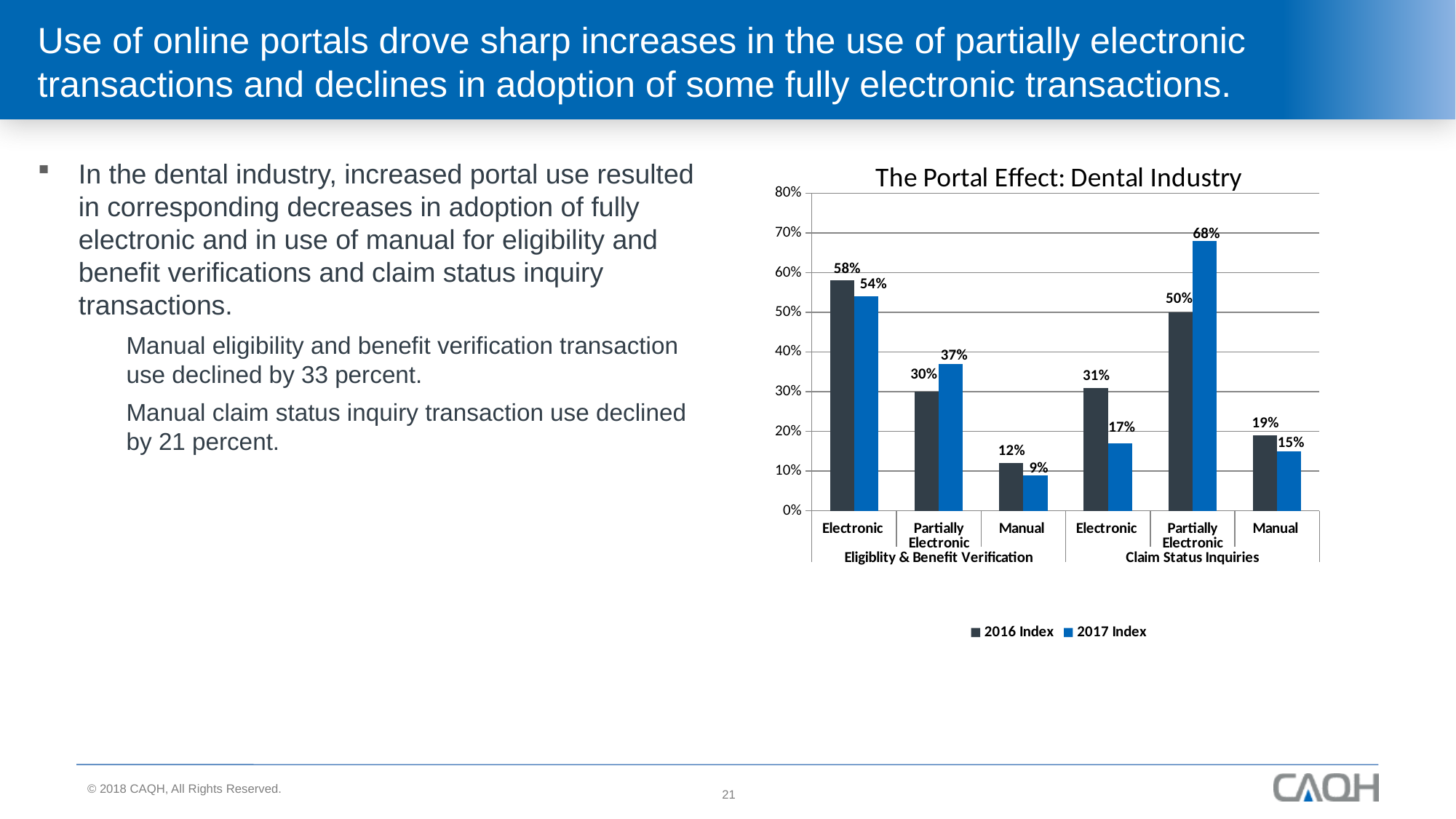
What is the 2017 Index value for Manual under Eligiblity & Benefit Verification? 9% What is the difference between the 2016 Index and 2017 Index values for Partially Electronic under Claim Status Inquiries? 18% What is the difference between the 2016 Index and 2017 Index values for Electronic under Claim Status Inquiries? 14% What is the 2016 Index value for Electronic under Eligiblity & Benefit Verification? 58% Which bar has the lowest value in the chart? 2017 Index, Manual, Eligiblity & Benefit Verification What kind of chart is shown on the slide? Bar chart Which is larger for Partially Electronic under Eligiblity & Benefit Verification: the 2016 Index or the 2017 Index? 2017 Index What is the 2017 Index value for Partially Electronic under Claim Status Inquiries? 68% How many series does the legend list? 2 What is the title of the chart? The Portal Effect: Dental Industry What is the 2016 Index value for Manual under Claim Status Inquiries? 19% Which bar has the highest value in the chart? 2017 Index, Partially Electronic, Claim Status Inquiries